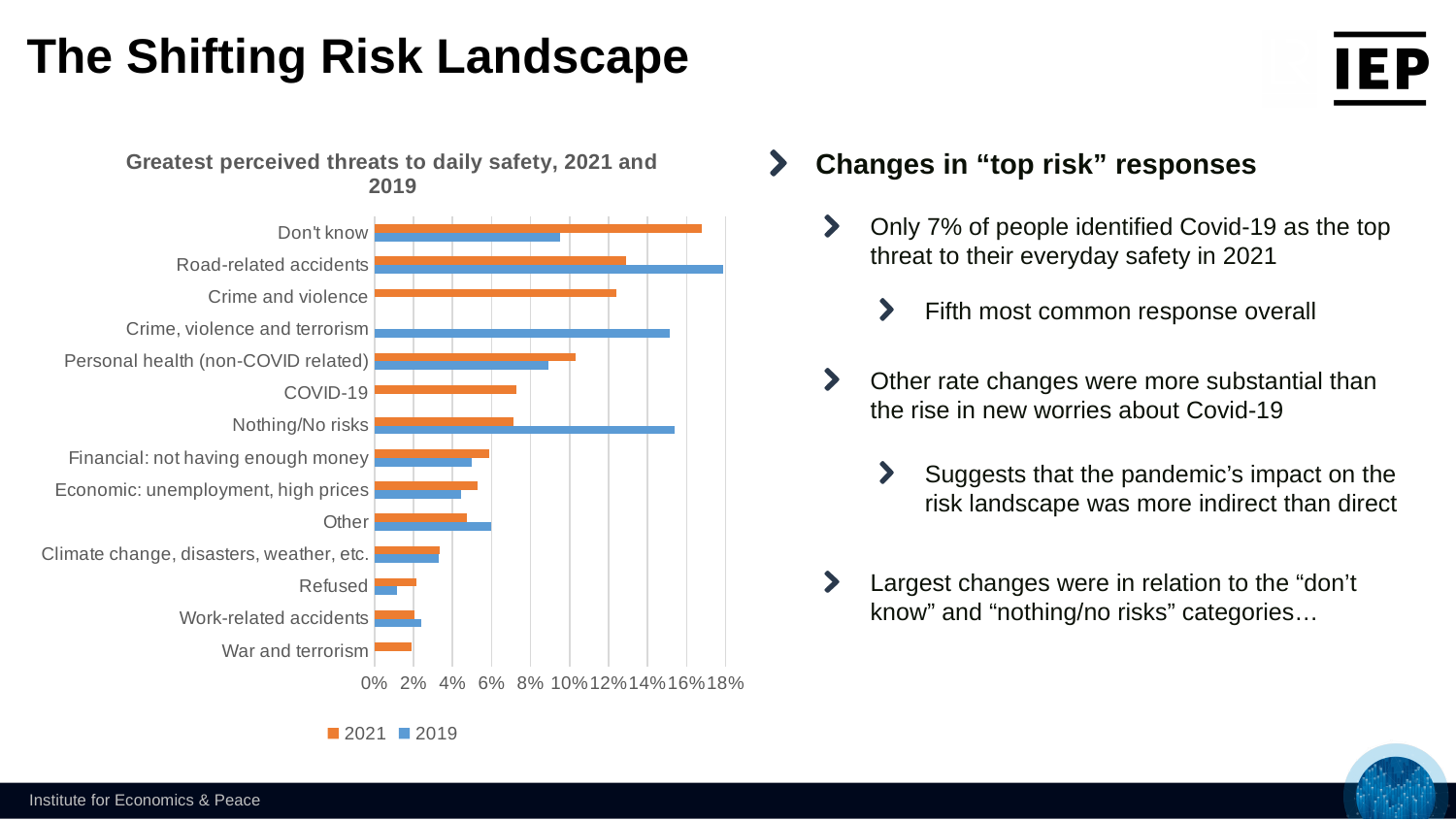
What is the title of the chart? Greatest perceived threats to daily safety, 2021 and 2019 Is the 2019 value for Road-related accidents greater or less than 16%? greater Is the 2021 value for Don't know greater or less than 16%? greater Which colour represents the 2019 series in the chart? Blue Which category has the highest value for 2019? Road-related accidents Which category has the highest value for 2021? Don't know How many categories are shown on the chart's vertical axis? 14 What kind of chart is shown on the slide? Bar chart For Don't know, which year has the larger value, 2021 or 2019? 2021 For Nothing/No risks, which year has the larger value, 2021 or 2019? 2019 How many series does the chart legend list? 2 Is the 2021 value for COVID-19 greater or less than 8%? less